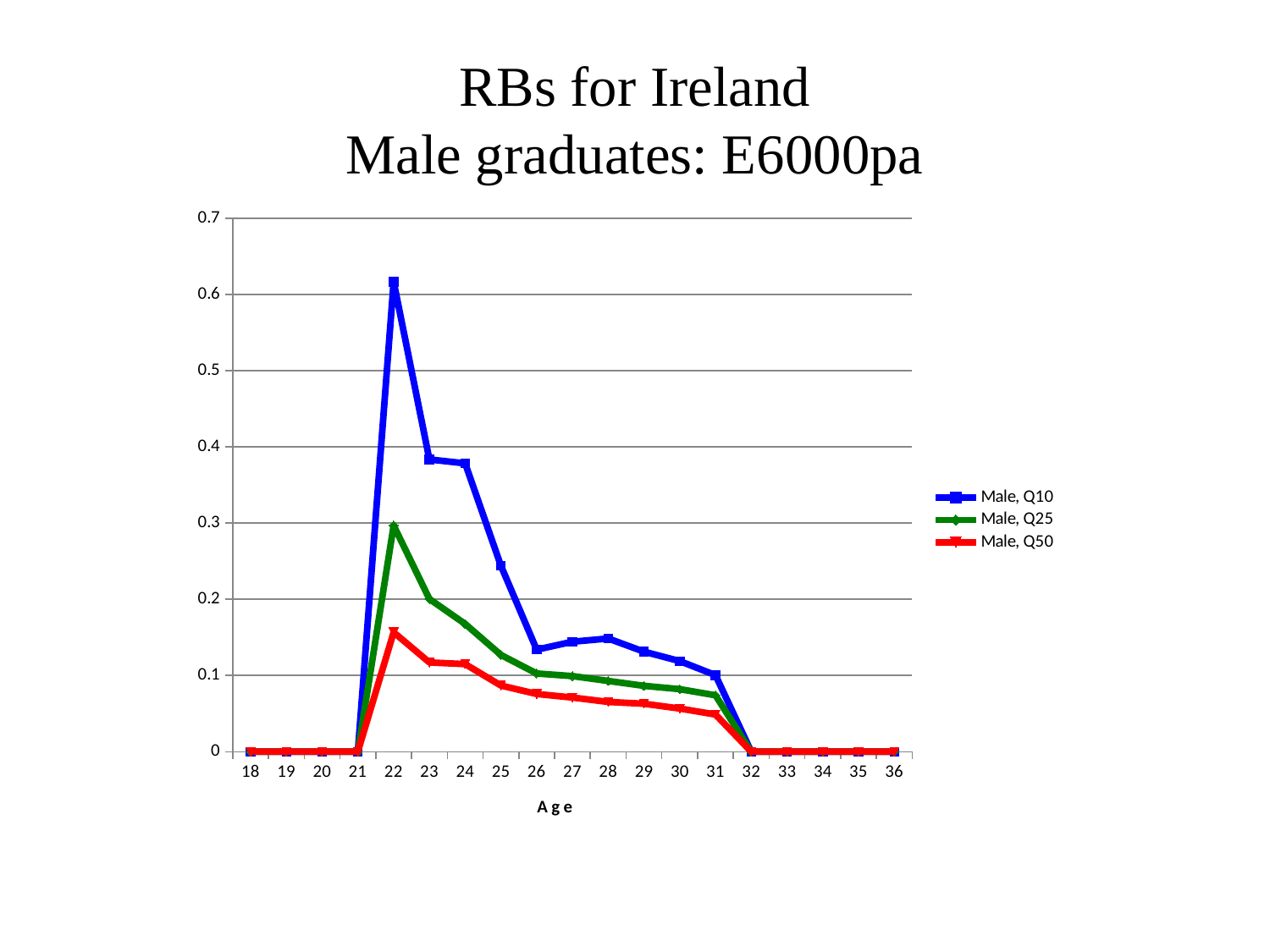
At age 24, which series has the larger value: Male, Q10 or Male, Q50? Male, Q10 What is the label of the x axis? Age What kind of chart is shown on the slide? line chart What is the value for Male, Q50 at age 34? 0 Is the value for Male, Q50 at age 22 greater or less than 0.2? less Between ages 22 and 26, does the Male, Q10 series rise or fall? fall What is the value for Male, Q10 at age 20? 0 How many age points are plotted along the x axis? 19 How many series does the legend list? 3 Is the value for Male, Q10 at age 22 greater or less than 0.6? greater At which age does the Male, Q10 series reach its highest value? 22